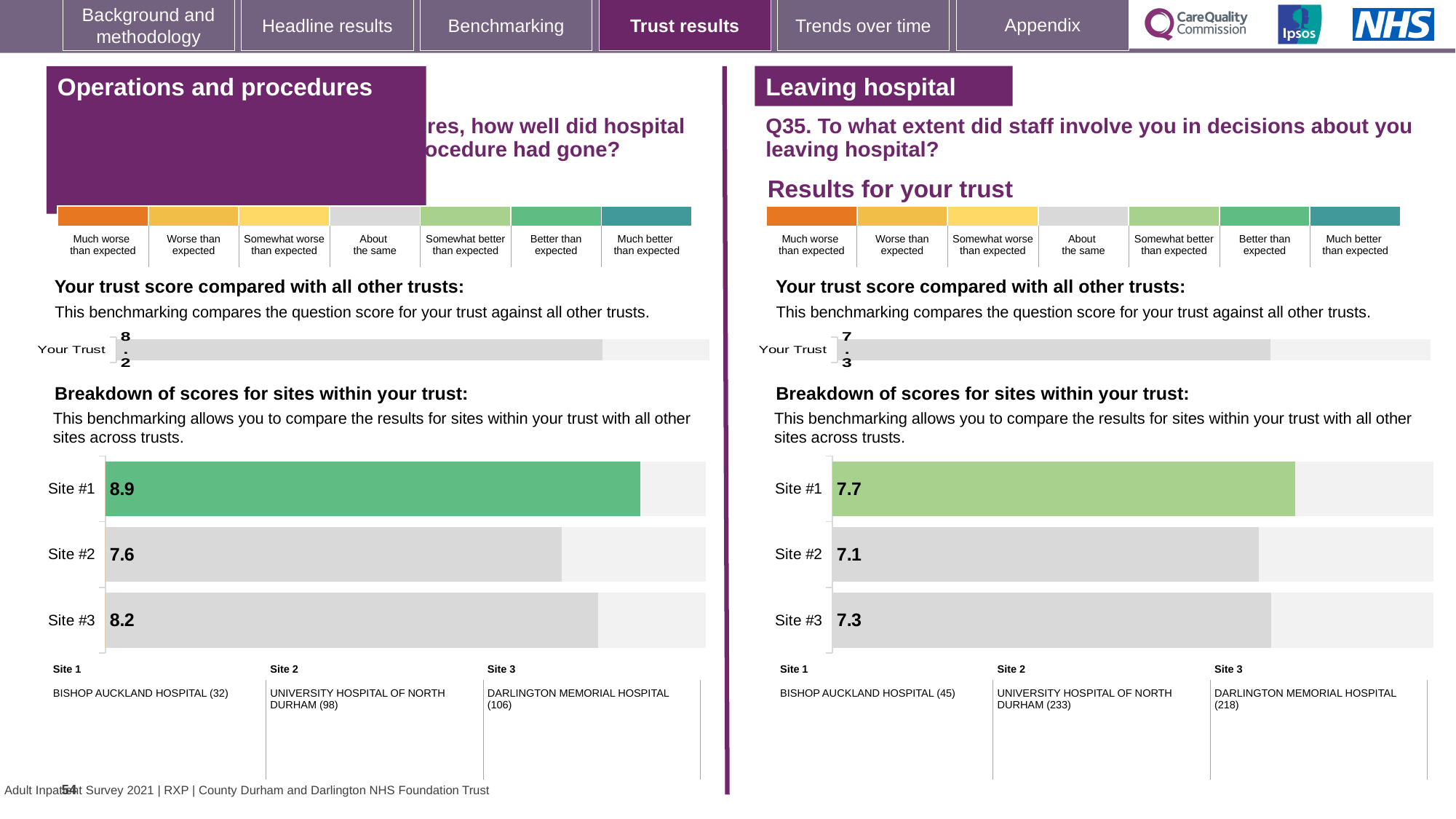
In the 'Your trust score compared with all other trusts' chart under 'Operations and procedures' (left side), what is the score for Your Trust? 8.2 In the site breakdown chart under 'Operations and procedures' (left side), which site has the highest score? Site #1 In the site breakdown chart under 'Operations and procedures' (left side), what is the difference between the scores for Site #1 and Site #2? 1.3 In the 'Your trust score compared with all other trusts' chart under 'Leaving hospital' (right side), what is the score for Your Trust? 7.3 In the site breakdown chart under 'Leaving hospital' (right side), what is the difference between the scores for Site #1 and Site #3? 0.4 In the site breakdown chart under 'Leaving hospital' (right side), which site has the lowest score? Site #2 How many sites are shown in the site breakdown chart under 'Leaving hospital' (right side)? 3 In the 'Breakdown of scores for sites within your trust' chart under 'Leaving hospital' (right side), what is the score for Site #2? 7.1 In the 'Breakdown of scores for sites within your trust' chart under 'Operations and procedures' (left side), what is the score for Site #1? 8.9 What kind of chart is the site breakdown chart under 'Operations and procedures' (left side)? Bar chart In the site breakdown chart under 'Leaving hospital' (right side), which has a higher score, Site #1 or Site #2? Site #1 In the site breakdown chart under 'Operations and procedures' (left side), which has a higher score, Site #2 or Site #3? Site #3